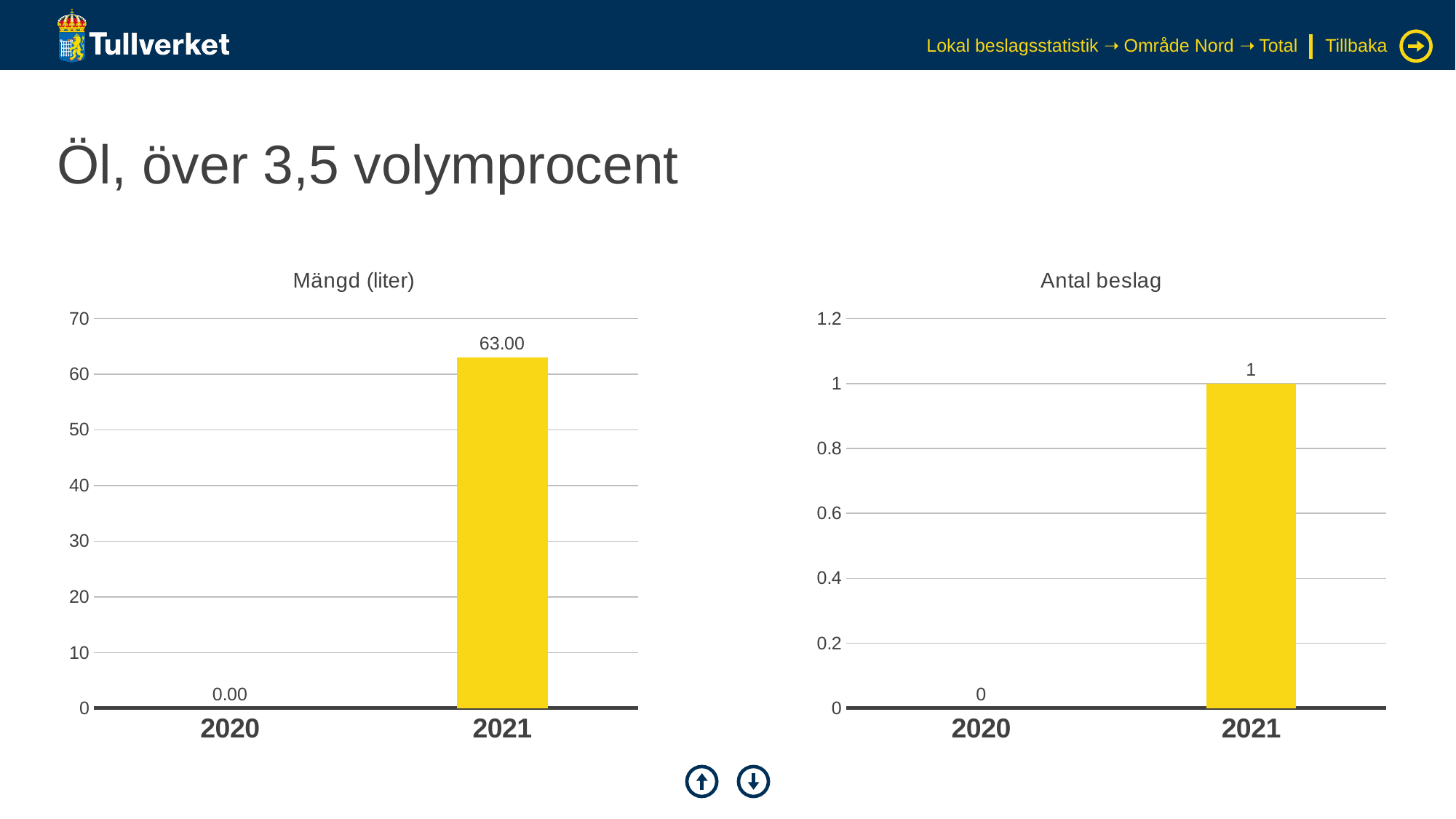
In the 'Mängd (liter)' chart, is the value for 2021 greater or less than 60? greater In the 'Antal beslag' chart, what is the value for 2020? 0 In the 'Mängd (liter)' chart, what is the value for 2020? 0.00 In the 'Mängd (liter)' chart, do the values rise or fall from 2020 to 2021? rise In the 'Mängd (liter)' chart, which year has the highest value? 2021 How many years are shown on the x axis of the 'Antal beslag' chart? 2 In the 'Antal beslag' chart, is the value for 2021 larger or smaller than the value for 2020? larger In the 'Antal beslag' chart, which year has the lowest value? 2020 In the 'Antal beslag' chart, what is the value for 2021? 1 What kind of chart is the 'Mängd (liter)' chart? bar chart In the 'Mängd (liter)' chart, what is the value for 2021? 63.00 In the 'Mängd (liter)' chart, what is the difference between the values for 2021 and 2020? 63.00